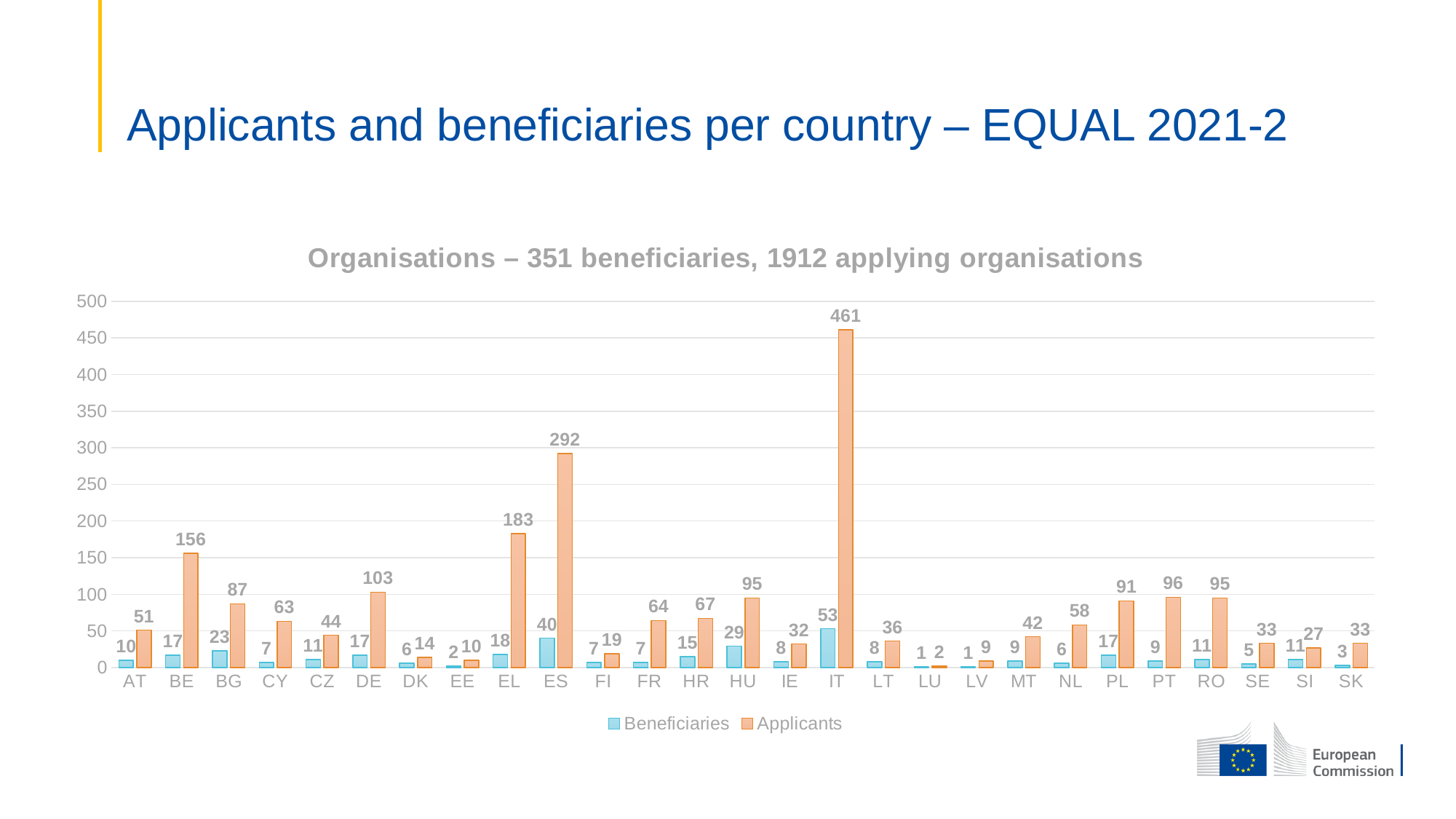
Which country has the lowest number of Applicants? LU What is the number of Beneficiaries for ES? 40 How many series does the legend list? 2 What is the number of Applicants for DE? 103 What is the number of Applicants for IT? 461 What is the difference between Applicants and Beneficiaries for IT? 408 Which country has the highest number of Applicants? IT How many countries are shown on the x axis? 27 Which has more Applicants, BE or DE? BE Which country has the highest number of Beneficiaries? IT What is the difference in Applicants between ES and EL? 109 What kind of chart is shown on the slide? Bar chart